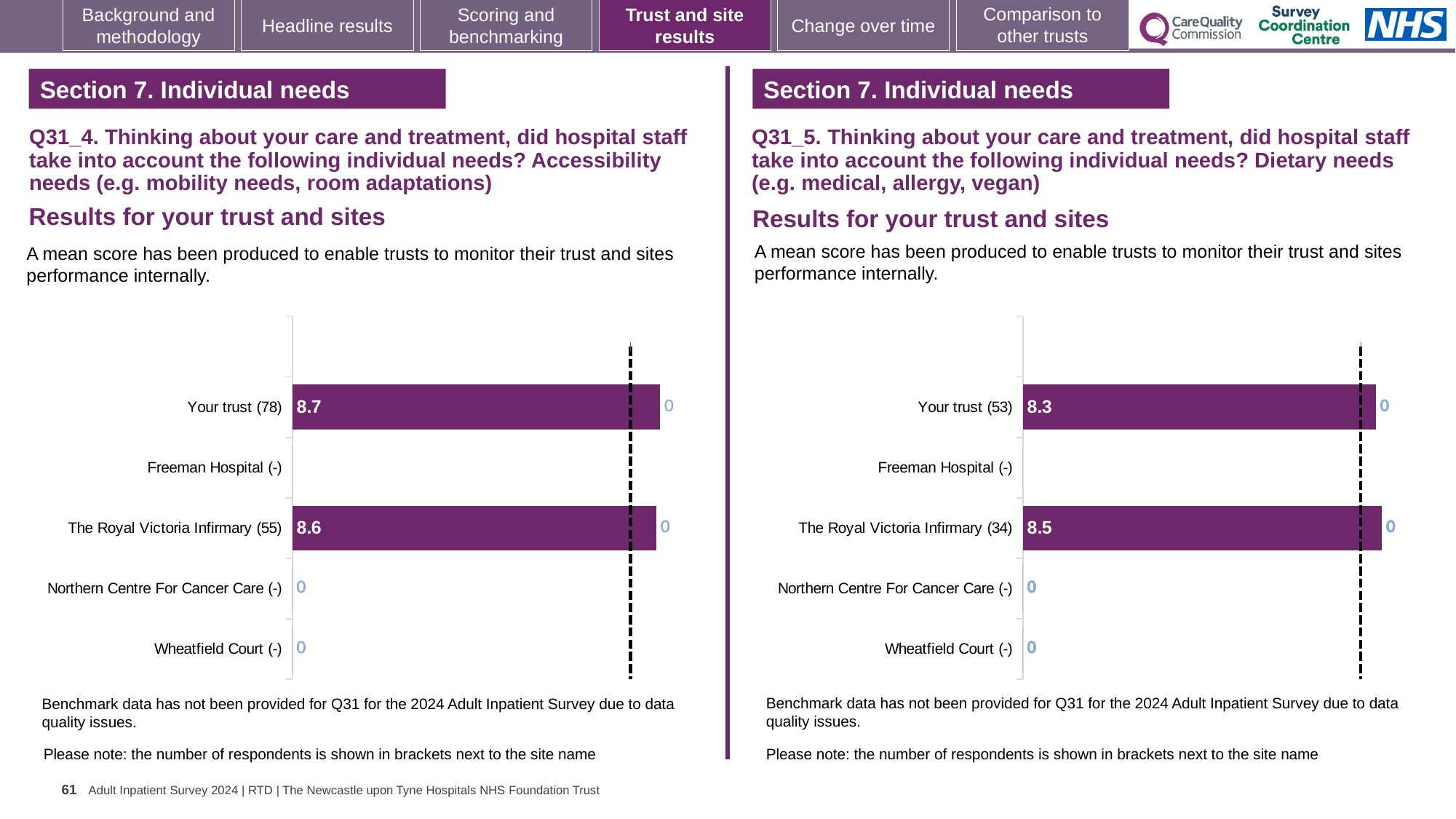
On the left chart (Q31_4, accessibility needs), which category has the highest mean score? Your trust On the left chart (Q31_4, accessibility needs), what is the difference between the mean scores for Your trust and The Royal Victoria Infirmary? 0.1 How many site/trust categories are listed on the left chart (Q31_4, accessibility needs)? 5 On the right chart (Q31_5, dietary needs), what is the mean score for Your trust? 8.3 On the left chart (Q31_4, accessibility needs), what is the mean score for Your trust? 8.7 On the left chart (Q31_4, accessibility needs), what is the mean score for The Royal Victoria Infirmary? 8.6 On the left chart (Q31_4, accessibility needs), how many respondents are shown in brackets for Your trust? 78 What type of chart is used on the right side of the slide (Q31_5, dietary needs)? Bar chart On the right chart (Q31_5, dietary needs), which has the higher mean score: Your trust or The Royal Victoria Infirmary? The Royal Victoria Infirmary On the right chart (Q31_5, dietary needs), what is the mean score for The Royal Victoria Infirmary? 8.5 On the right chart (Q31_5, dietary needs), what is the difference between the mean scores for The Royal Victoria Infirmary and Your trust? 0.2 On the right chart (Q31_5, dietary needs), how many respondents are shown in brackets for The Royal Victoria Infirmary? 34